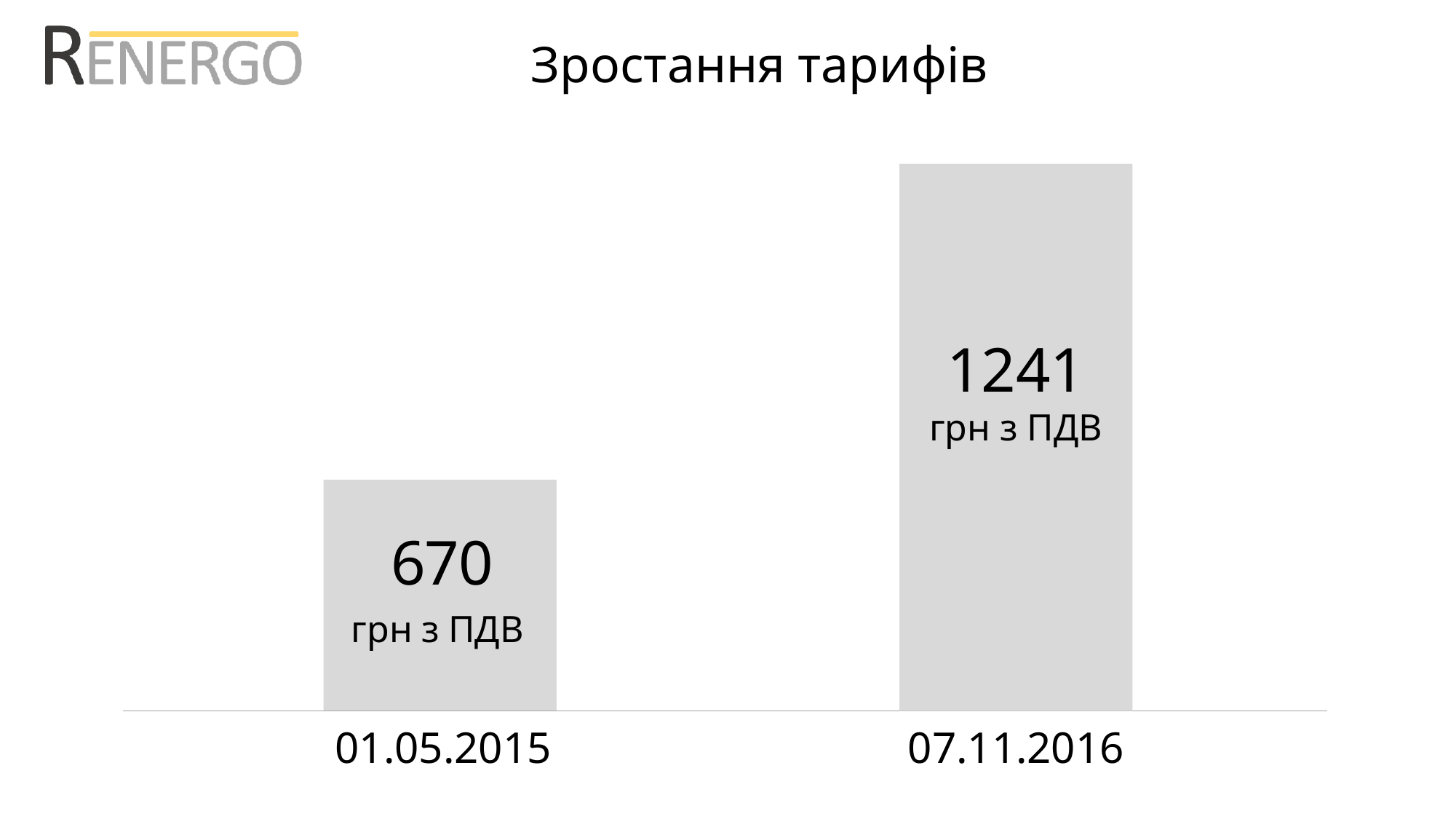
What is the title of the slide? Зростання тарифів What unit is shown on the data labels? грн з ПДВ What kind of chart is shown on the slide? bar chart What is the value for 07.11.2016? 1241 грн з ПДВ Which date has the lowest value? 01.05.2015 Which is larger, the value for 01.05.2015 or the value for 07.11.2016? 07.11.2016 How many bars are shown in the chart? 2 Do the values rise or fall from 01.05.2015 to 07.11.2016? rise What is the difference between the values for 07.11.2016 and 01.05.2015? 571 What is the value for 01.05.2015? 670 грн з ПДВ Which date has the highest value? 07.11.2016